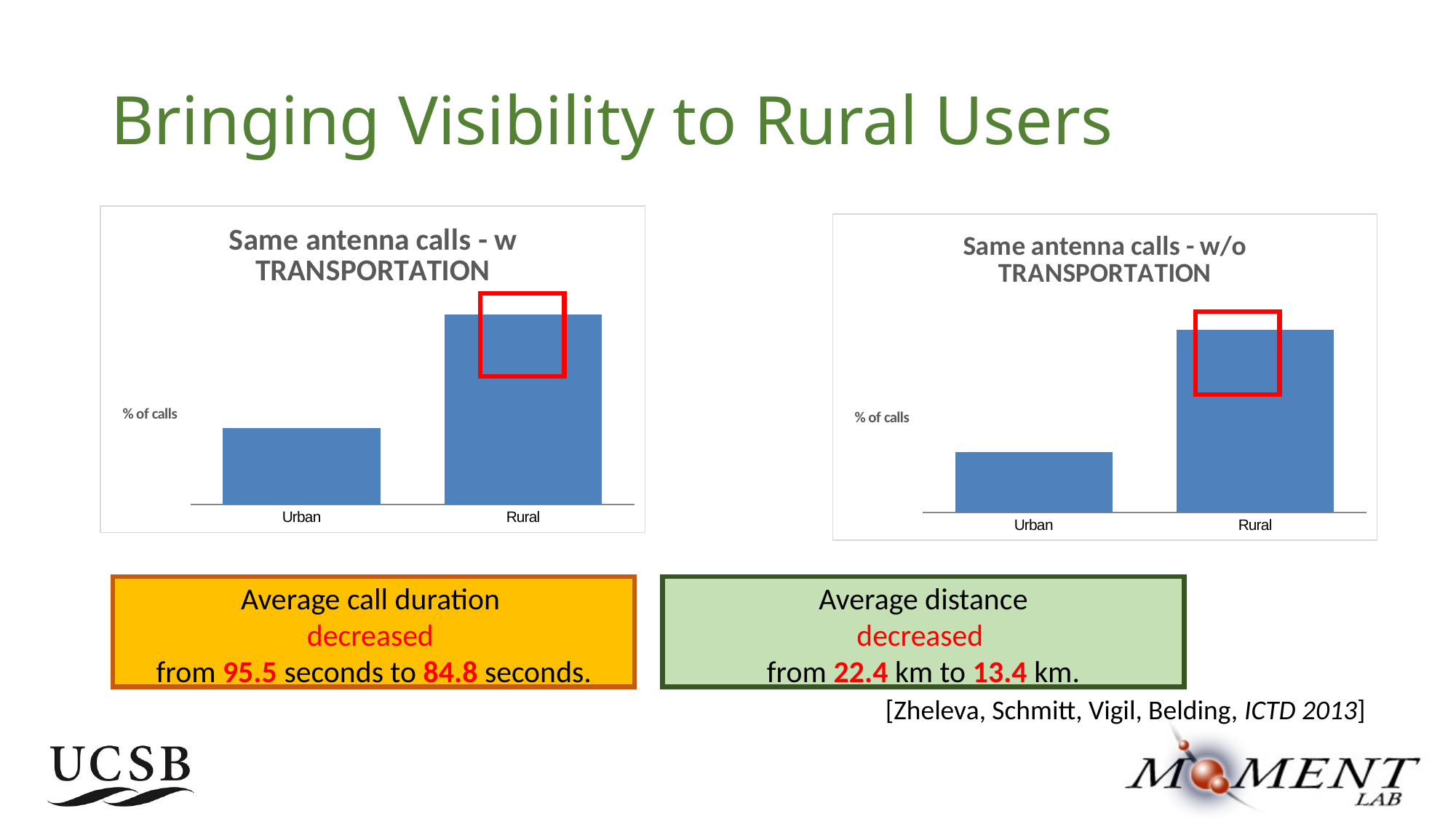
In the chart titled "Same antenna calls - w/o TRANSPORTATION", which category has the higher percentage of calls? Rural What type of chart is the right chart on the slide? Bar chart In the chart titled "Same antenna calls - w/o TRANSPORTATION", which category has the lower percentage of calls? Urban In the chart titled "Same antenna calls - w TRANSPORTATION", which category has the lower percentage of calls? Urban What is the title of the left chart on the slide? Same antenna calls - w TRANSPORTATION How many categories are shown in the chart titled "Same antenna calls - w/o TRANSPORTATION"? 2 What type of chart is the left chart on the slide? Bar chart How many categories are shown in the chart titled "Same antenna calls - w TRANSPORTATION"? 2 What is the y-axis label of the right chart on the slide? % of calls In the left chart, is the bar for Urban or the bar for Rural taller? Rural In the chart titled "Same antenna calls - w TRANSPORTATION", which category has the higher percentage of calls? Rural In the right chart, is the bar for Urban or the bar for Rural taller? Rural